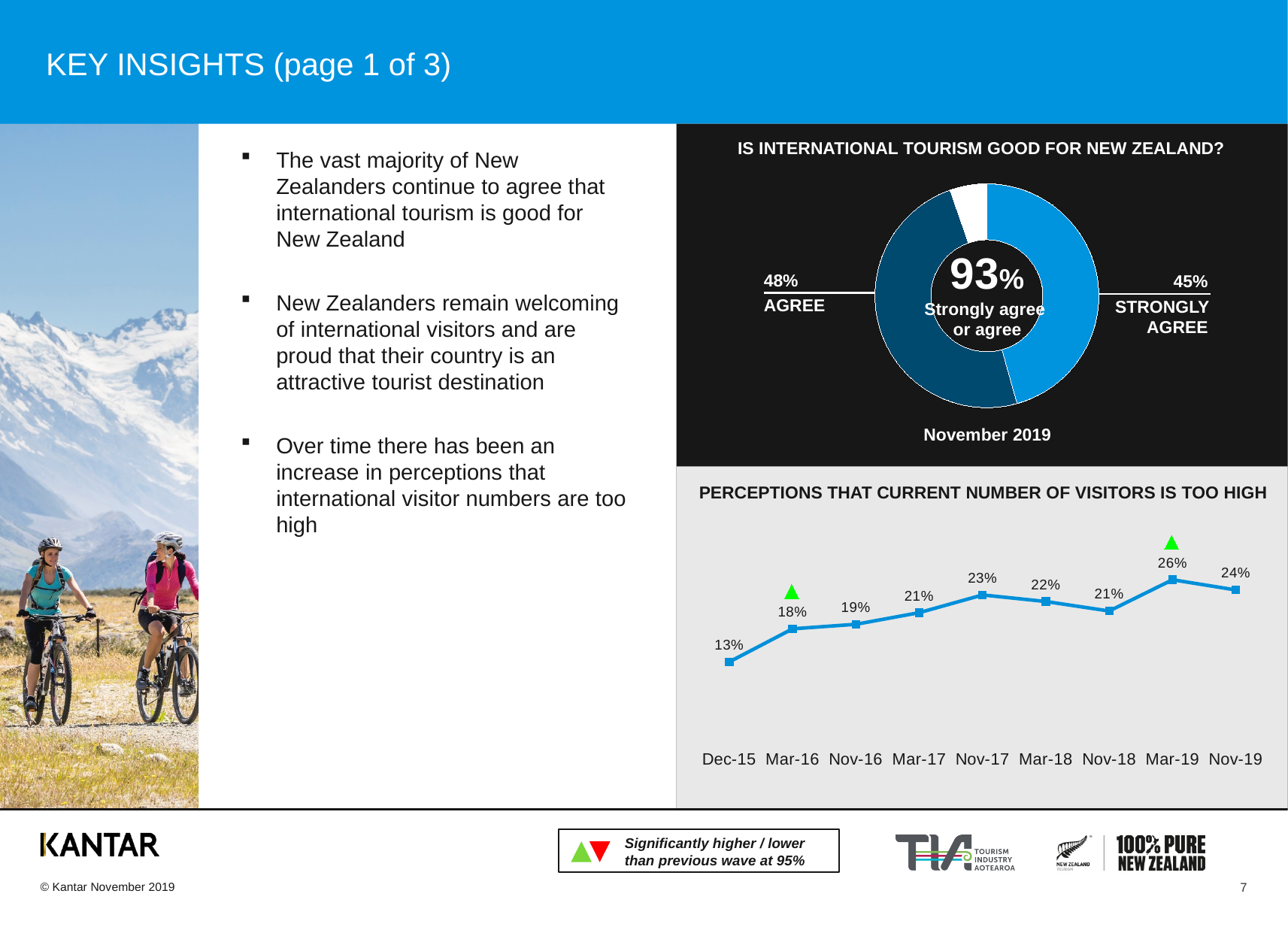
In the chart 'PERCEPTIONS THAT CURRENT NUMBER OF VISITORS IS TOO HIGH', which period has the highest value? Mar-19 In the chart 'PERCEPTIONS THAT CURRENT NUMBER OF VISITORS IS TOO HIGH', what is the value for Dec-15? 13% In the chart 'PERCEPTIONS THAT CURRENT NUMBER OF VISITORS IS TOO HIGH', which is larger, the value for Nov-17 or the value for Nov-18? Nov-17 What kind of chart is 'PERCEPTIONS THAT CURRENT NUMBER OF VISITORS IS TOO HIGH'? Line chart In the chart 'PERCEPTIONS THAT CURRENT NUMBER OF VISITORS IS TOO HIGH', do the values generally rise or fall from Dec-15 to Nov-19? Rise In the chart 'IS INTERNATIONAL TOURISM GOOD FOR NEW ZEALAND?', what percentage strongly agree? 45% In the chart 'PERCEPTIONS THAT CURRENT NUMBER OF VISITORS IS TOO HIGH', what is the value for Nov-19? 24% What kind of chart is 'IS INTERNATIONAL TOURISM GOOD FOR NEW ZEALAND?'? Donut chart In the chart 'PERCEPTIONS THAT CURRENT NUMBER OF VISITORS IS TOO HIGH', what is the difference between the Mar-19 and Nov-19 values? 2% In the chart 'PERCEPTIONS THAT CURRENT NUMBER OF VISITORS IS TOO HIGH', which period has the lowest value? Dec-15 In the chart 'IS INTERNATIONAL TOURISM GOOD FOR NEW ZEALAND?', what is the combined percentage who strongly agree or agree? 93% How many time periods are plotted in the chart 'PERCEPTIONS THAT CURRENT NUMBER OF VISITORS IS TOO HIGH'? 9